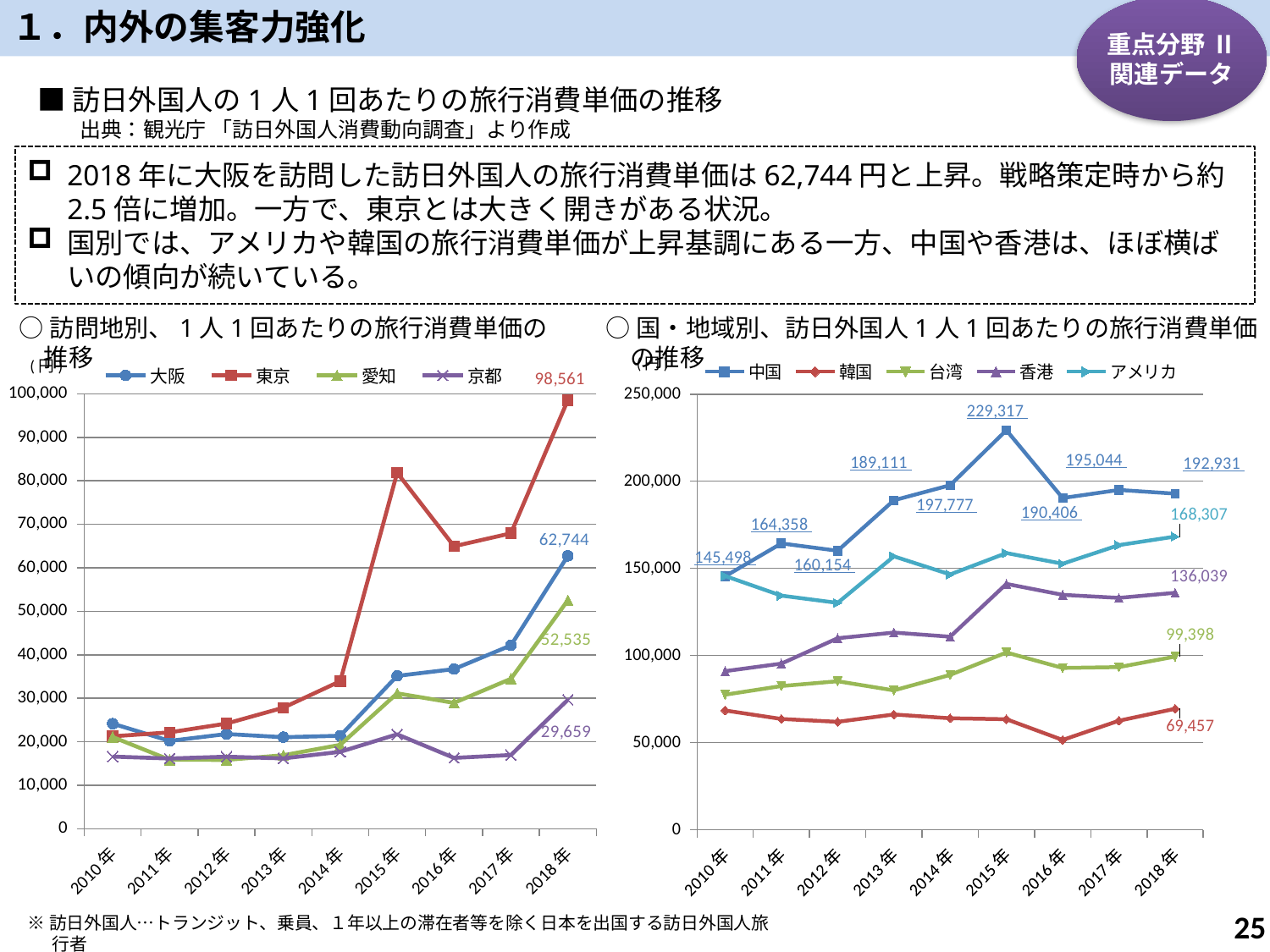
In the right chart (国・地域別), what is the value for 中国 in 2015年? 229,317 In the right chart (国・地域別), in which year does 中国 reach its highest value? 2015年 In the left chart (訪問地別), what is the value for 東京 in 2018年? 98,561 What kind of chart is the left chart (訪問地別)? Line chart In the left chart (訪問地別), which series has the highest value in 2018年? 東京 In the right chart (国・地域別), is the value for 香港 in 2010年 greater or less than 100,000? less In the right chart (国・地域別), what is the difference between the 2018年 values for 中国 and アメリカ? 24,624 In the right chart (国・地域別), how many series does the legend list? 5 In the right chart (国・地域別), what is the value for アメリカ in 2018年? 168,307 In the left chart (訪問地別), what is the difference between the 2018年 values for 東京 and 大阪? 35,817 In the left chart (訪問地別), how many series does the legend list? 4 In the left chart (訪問地別), what is the value for 大阪 in 2018年? 62,744